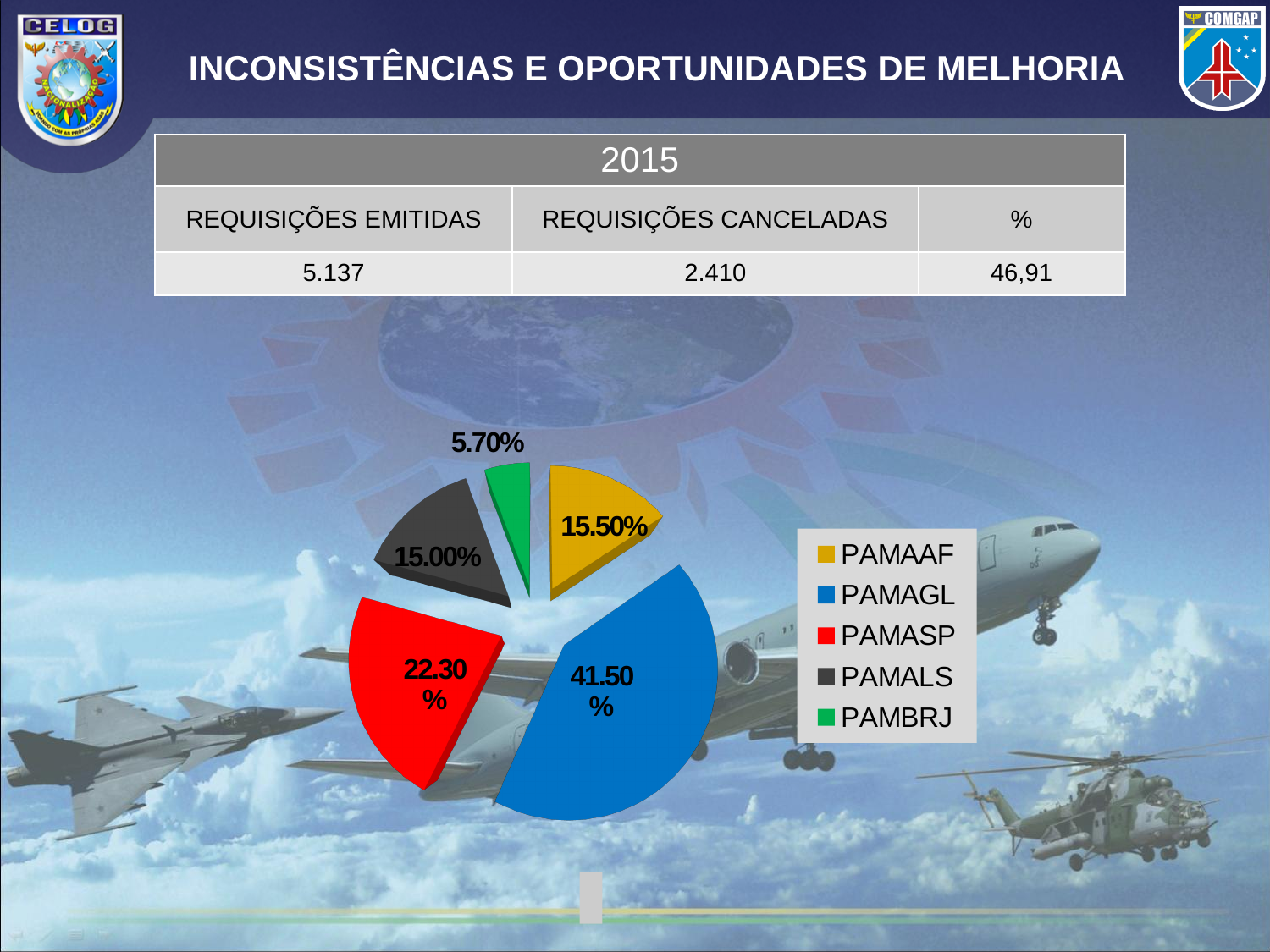
What kind of chart is shown on the slide? pie chart What percentage does the PAMAGL slice show? 41.50% What is the difference in percentage points between the PAMAGL and PAMASP slices? 19.20 Which category has the largest slice of the pie? PAMAGL How many entries does the legend list? 5 What percentage does the PAMAAF slice show? 15.50% What percentage does the PAMBRJ slice show? 5.70% Which slice is larger, PAMASP or PAMALS? PAMASP How many slices does the pie chart have? 5 What colour is the PAMALS slice? dark gray What percentage does the PAMASP slice show? 22.30% Which category has the smallest slice of the pie? PAMBRJ